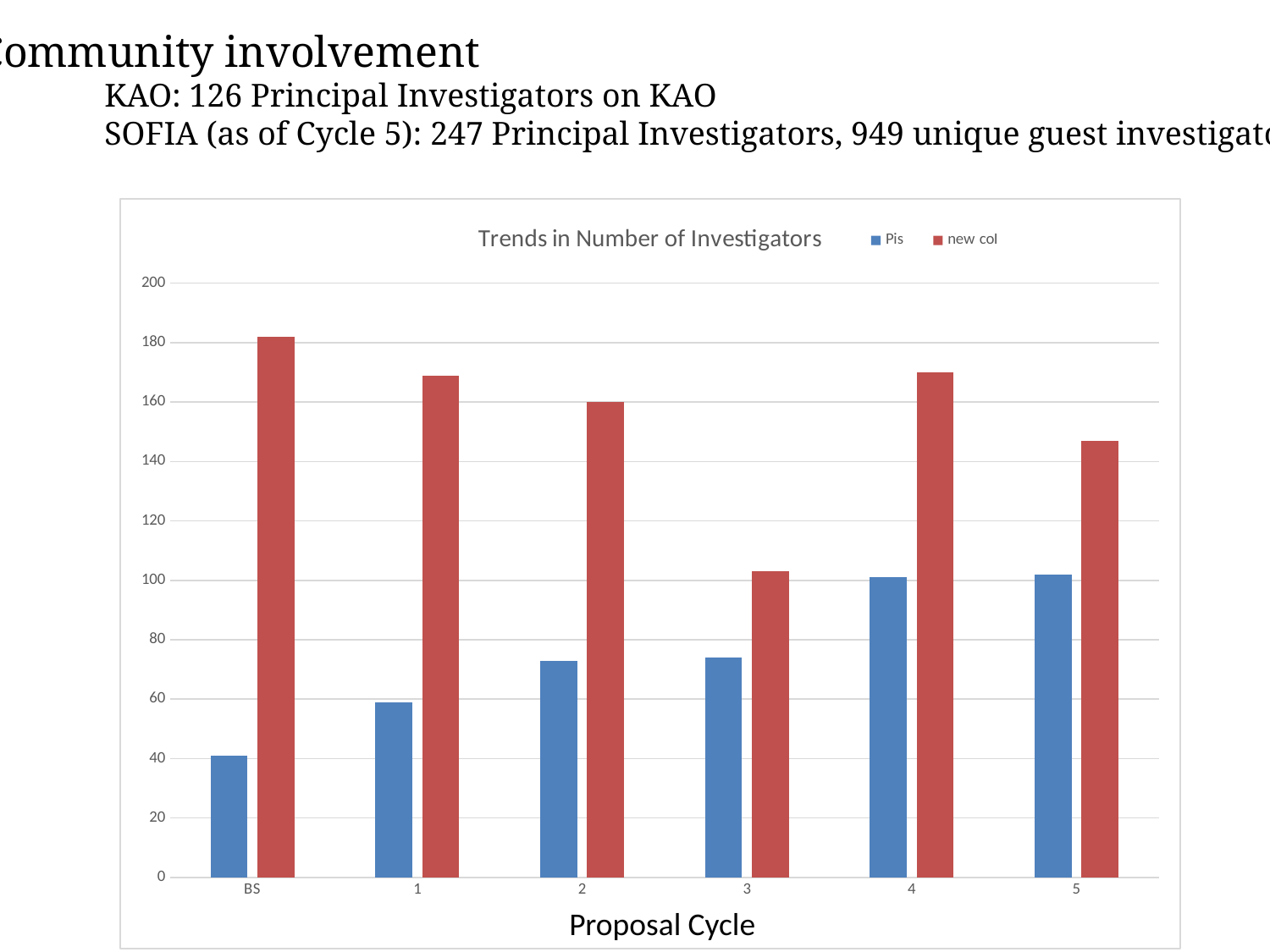
How many series does the legend list? 2 Is the new coI value for cycle 5 greater or less than 140? greater Do the Pis values rise or fall from BS to cycle 5? rise Is the new coI value for cycle 3 greater or less than 120? less How many proposal cycle categories are shown on the x axis? 6 Which proposal cycle has the highest value for the new coI series? BS What kind of chart is shown on the slide? bar chart Is the Pis value for BS greater or less than 60? less Which proposal cycle has the lowest value for the new coI series? 3 Which proposal cycle has the lowest value for the Pis series? BS Which is larger, the new coI value for cycle 2 or for cycle 5? cycle 2 What is the title of the chart? Trends in Number of Investigators